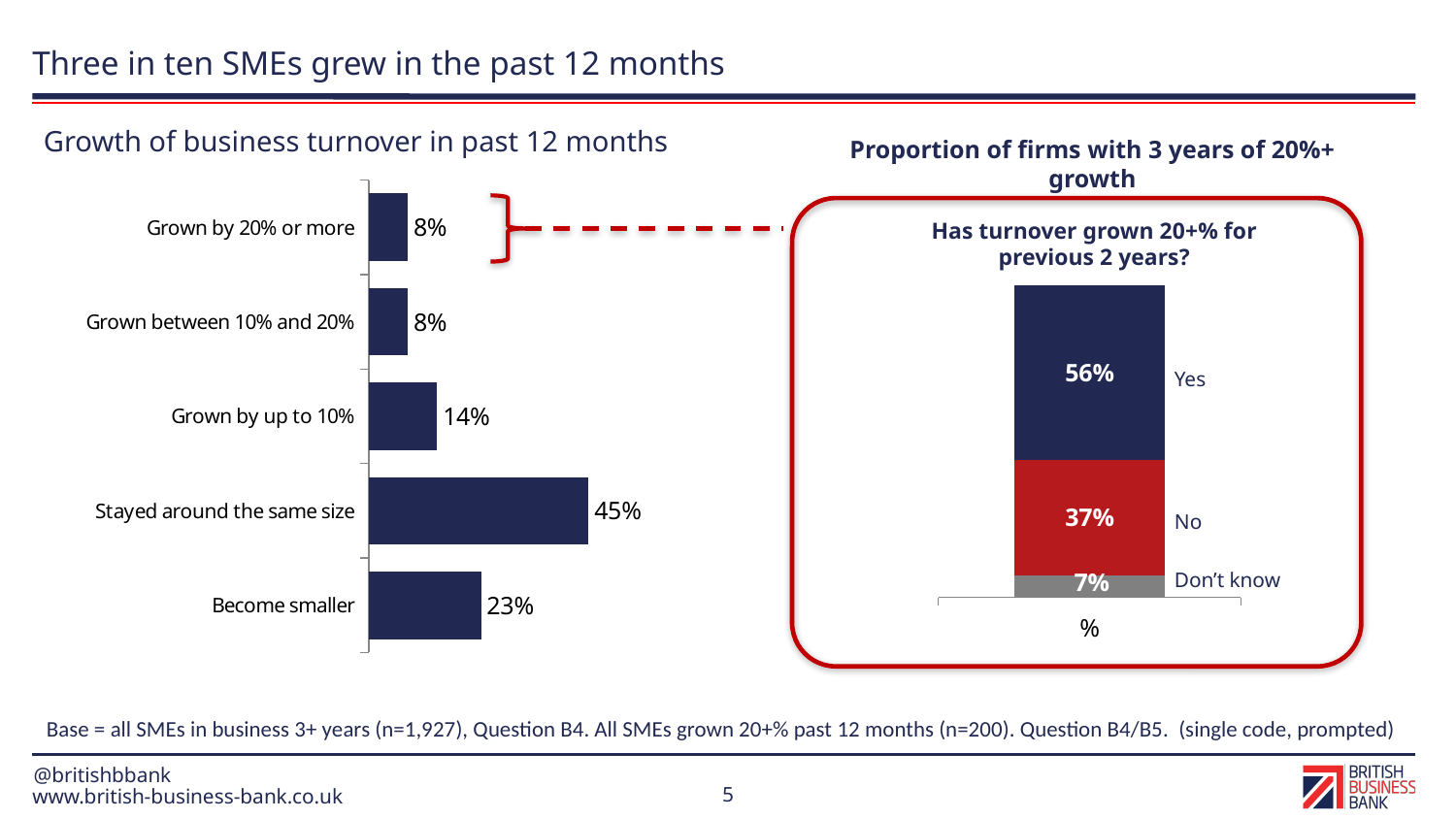
In the 'Growth of business turnover in past 12 months' chart, what is the value for 'Grown by up to 10%'? 14% What type of chart is 'Growth of business turnover in past 12 months'? Bar chart In the 'Proportion of firms with 3 years of 20%+ growth' chart, what is the total of the stacked bar? 100% In the 'Growth of business turnover in past 12 months' chart, what percentage of SMEs stayed around the same size? 45% In the 'Growth of business turnover in past 12 months' chart, which category has the highest value? Stayed around the same size How many categories are shown in the 'Growth of business turnover in past 12 months' chart? 5 In the 'Growth of business turnover in past 12 months' chart, which is larger: 'Grown by up to 10%' or 'Become smaller'? Become smaller In the 'Proportion of firms with 3 years of 20%+ growth' chart, what is the difference between 'Yes' and 'No'? 19 percentage points In the 'Proportion of firms with 3 years of 20%+ growth' chart, what percentage answered 'Don't know'? 7% In the 'Proportion of firms with 3 years of 20%+ growth' chart, what percentage answered 'Yes'? 56% In the 'Growth of business turnover in past 12 months' chart, what percentage of SMEs have become smaller? 23% In the 'Growth of business turnover in past 12 months' chart, what is the difference between 'Stayed around the same size' and 'Become smaller'? 22 percentage points